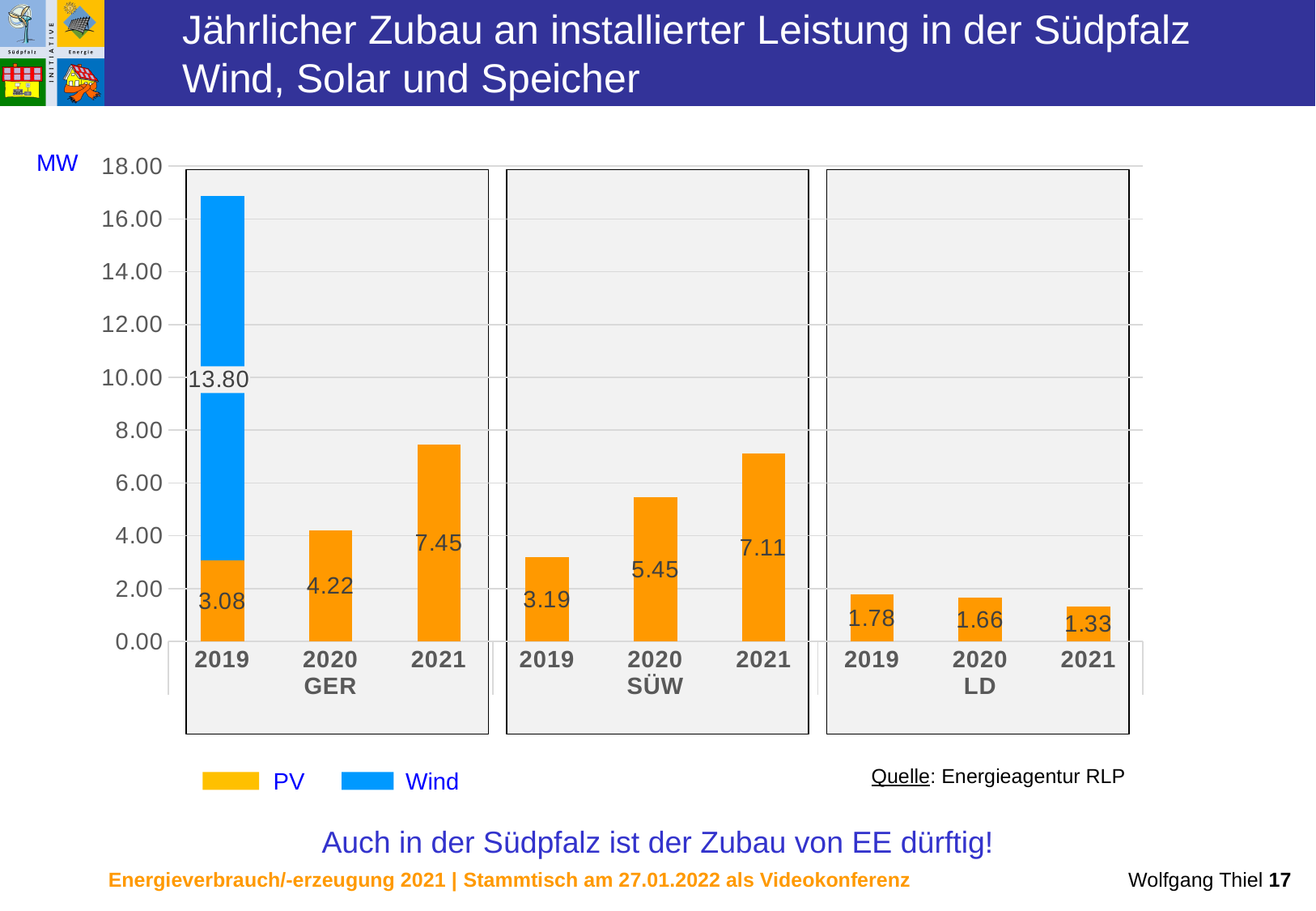
Which is larger, the PV value for SÜW in 2020 or for GER in 2020? SÜW in 2020 What is the PV value for GER in 2019? 3.08 What is the Wind value for GER in 2019? 13.80 What kind of chart is shown on the slide? Stacked bar chart How many series does the legend list? 2 What is the total height of the stacked bar for GER in 2019? 16.88 What is the PV value for LD in 2020? 1.66 Which year has the highest PV value for GER? 2021 Do the PV values for LD rise or fall from 2019 to 2021? Fall What is the difference between the PV values for GER in 2021 and 2020? 3.23 What is the PV value for SÜW in 2021? 7.11 Which year has the lowest PV value for LD? 2021